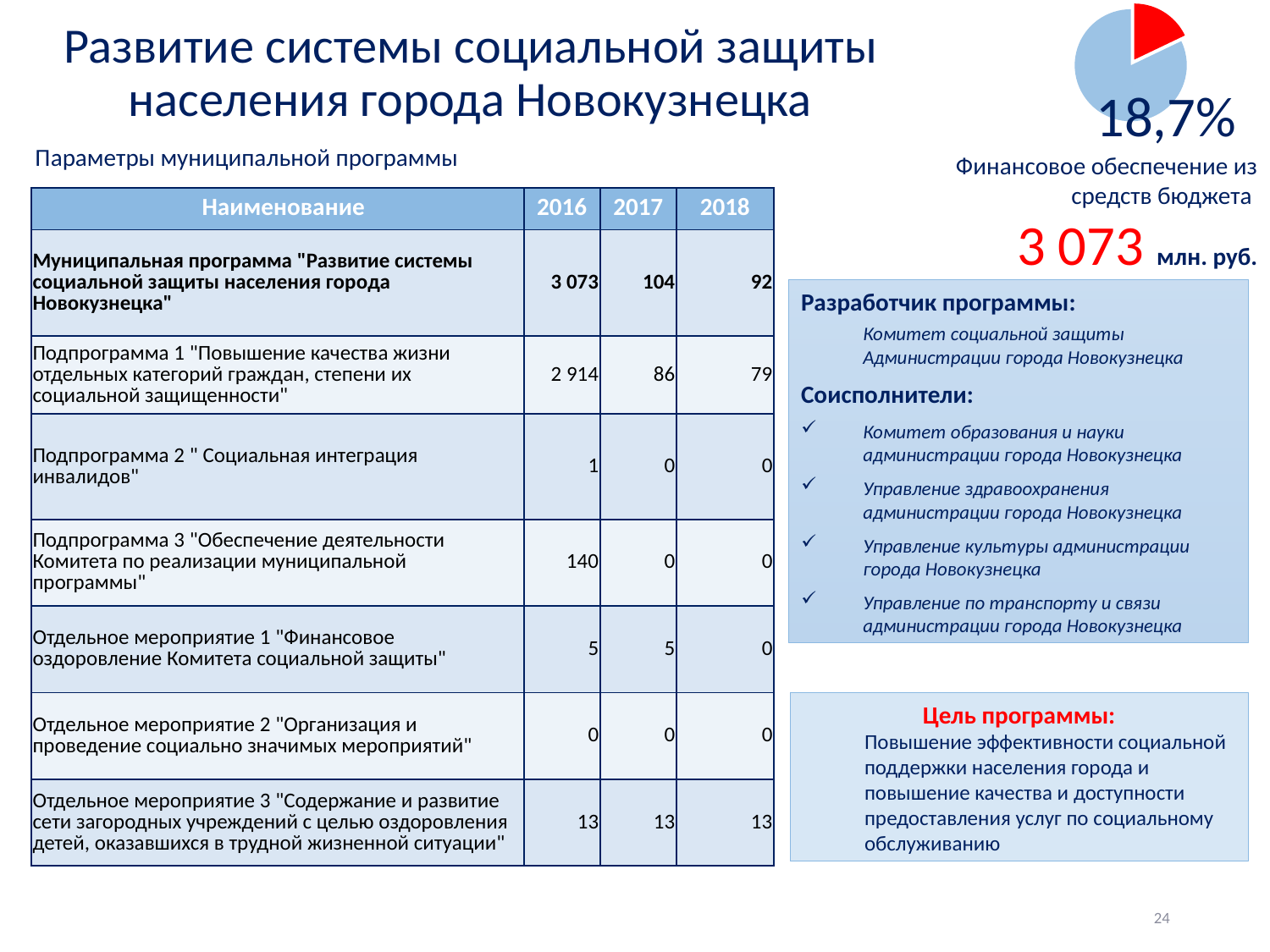
How many slices does the pie chart in the top right corner have? 2 In the pie chart, which slice is larger, the red one or the light blue one? the light blue one What percentage is printed next to the pie chart in the top right corner? 18,7% Which slice of the pie chart is the smallest? the red slice What share of the pie chart does the red slice represent? 18,7% What kind of chart is shown in the top right corner of the slide? pie chart What colour is the smaller slice of the pie chart? red